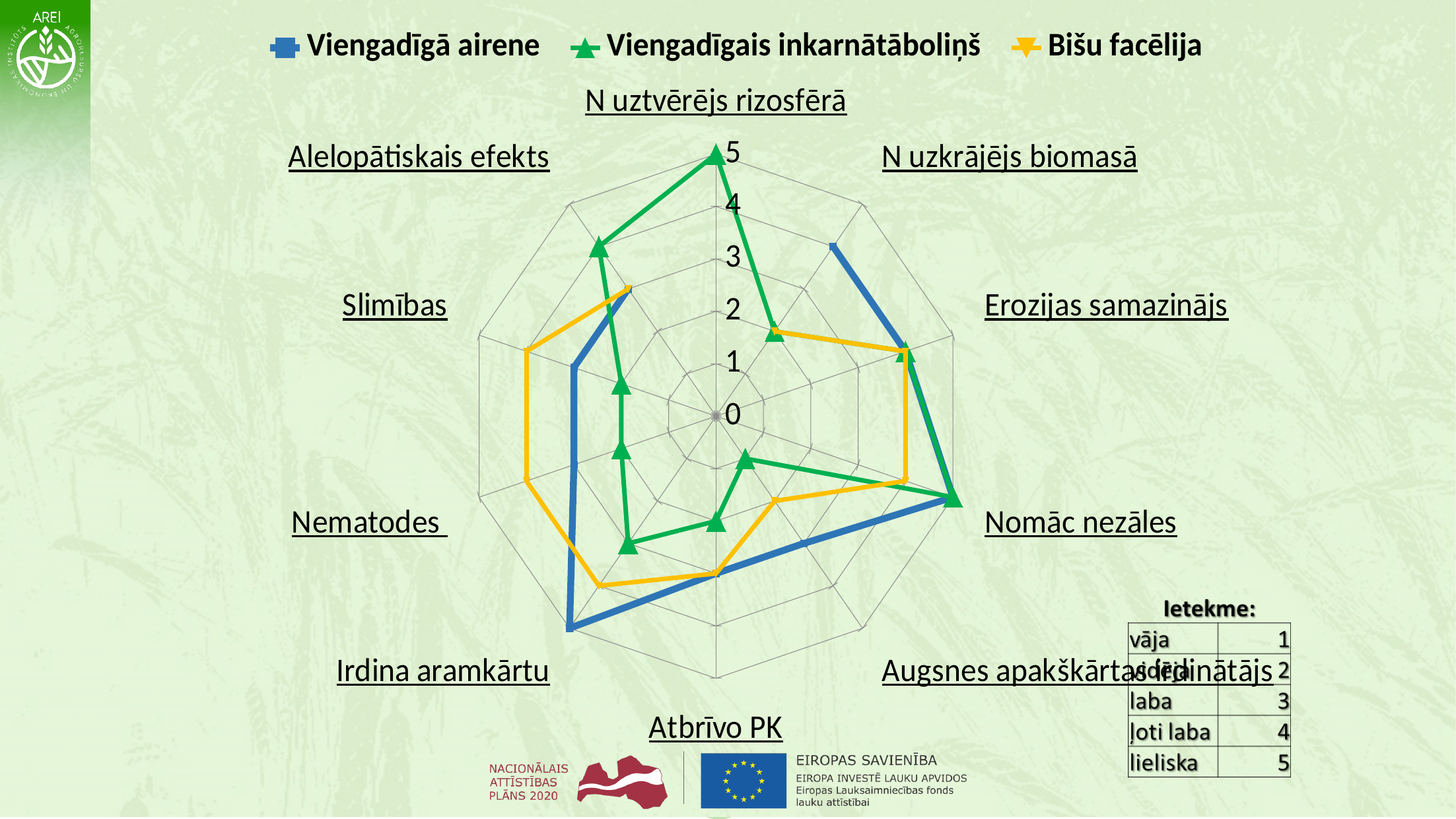
Is the value for Bišu facēlija on the Nematodes axis greater or less than 3? greater On the Irdina aramkārtu axis, which series has the larger value: Viengadīgā airene or Viengadīgais inkarnātāboliņš? Viengadīgā airene On the Nematodes axis, which series has the larger value: Bišu facēlija or Viengadīgais inkarnātāboliņš? Bišu facēlija On which axis does Viengadīgais inkarnātāboliņš have its lowest value? Augsnes apakškārtas irdinātājs What is the maximum value shown on the radar chart's scale? 5 What is the value for Viengadīgā airene on the Irdina aramkārtu axis? 5 What kind of chart is shown on the slide? radar chart On which axis does Viengadīgais inkarnātāboliņš reach its highest value? N uztvērējs rizosfērā and Nomāc nezāles What is the value for Viengadīgā airene on the Nomāc nezāles axis? 5 How many categories (axes) does the radar chart have? 10 How many series does the legend list? 3 What is the value for Viengadīgais inkarnātāboliņš on the N uztvērējs rizosfērā axis? 5